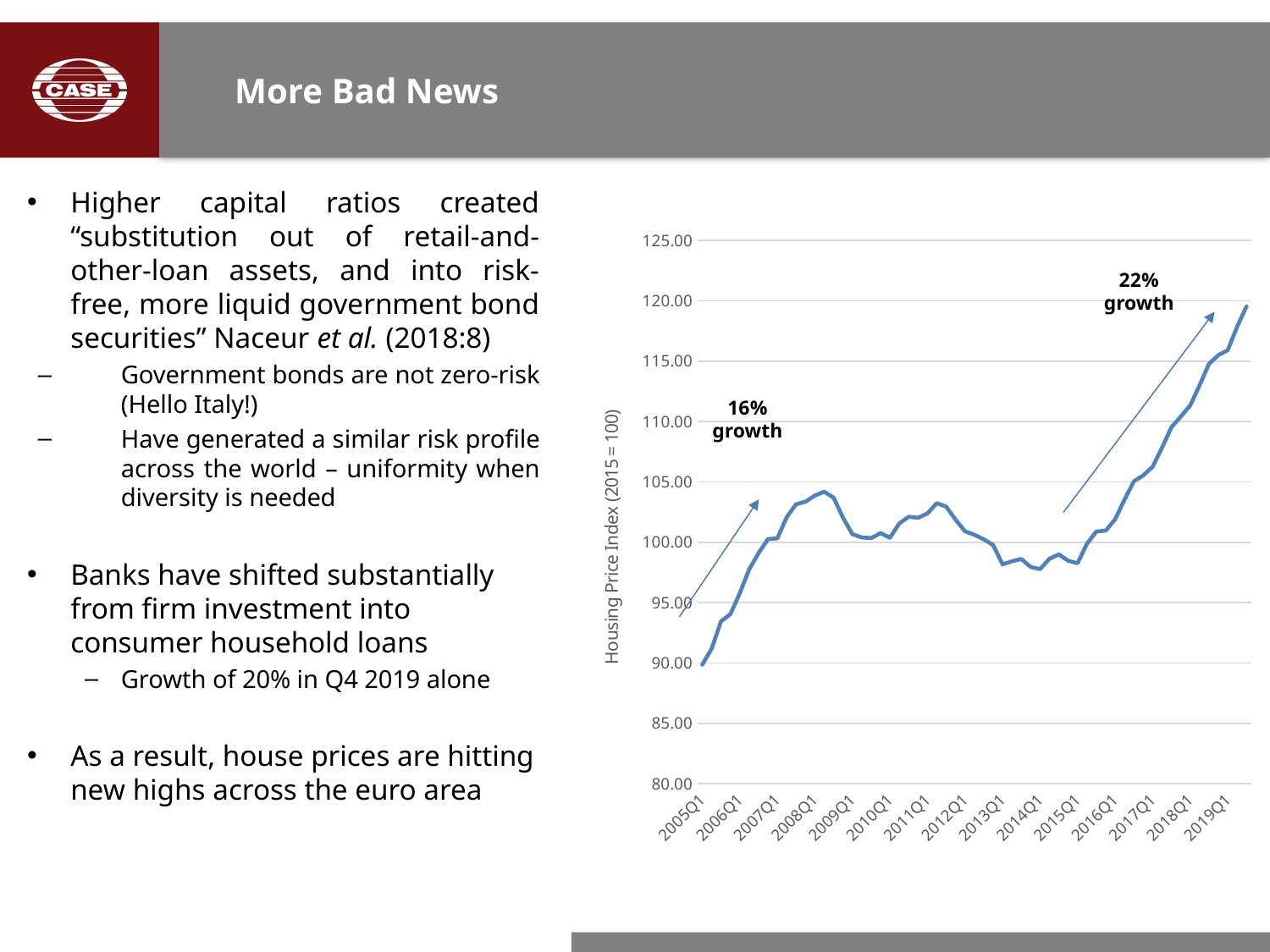
Which labelled quarter on the x axis has the highest Housing Price Index value? 2019Q1 Is the value for 2005Q1 greater or less than 95.00? less Which is larger, the Housing Price Index for 2019Q1 or for 2008Q1? 2019Q1 Does the Housing Price Index rise or fall between 2008Q1 and 2009Q1? fall What is the label on the vertical axis of the chart? Housing Price Index (2015 = 100) Which labelled quarter on the x axis has the lowest Housing Price Index value? 2005Q1 Does the Housing Price Index rise or fall between 2015Q1 and 2019Q1? rise Is the value for 2014Q1 greater or less than 100.00? less What kind of chart is shown on the slide? line chart Is the value for 2008Q1 greater or less than 100.00? greater What growth percentage is annotated on the chart for the rise ending around 2019Q1? 22% growth